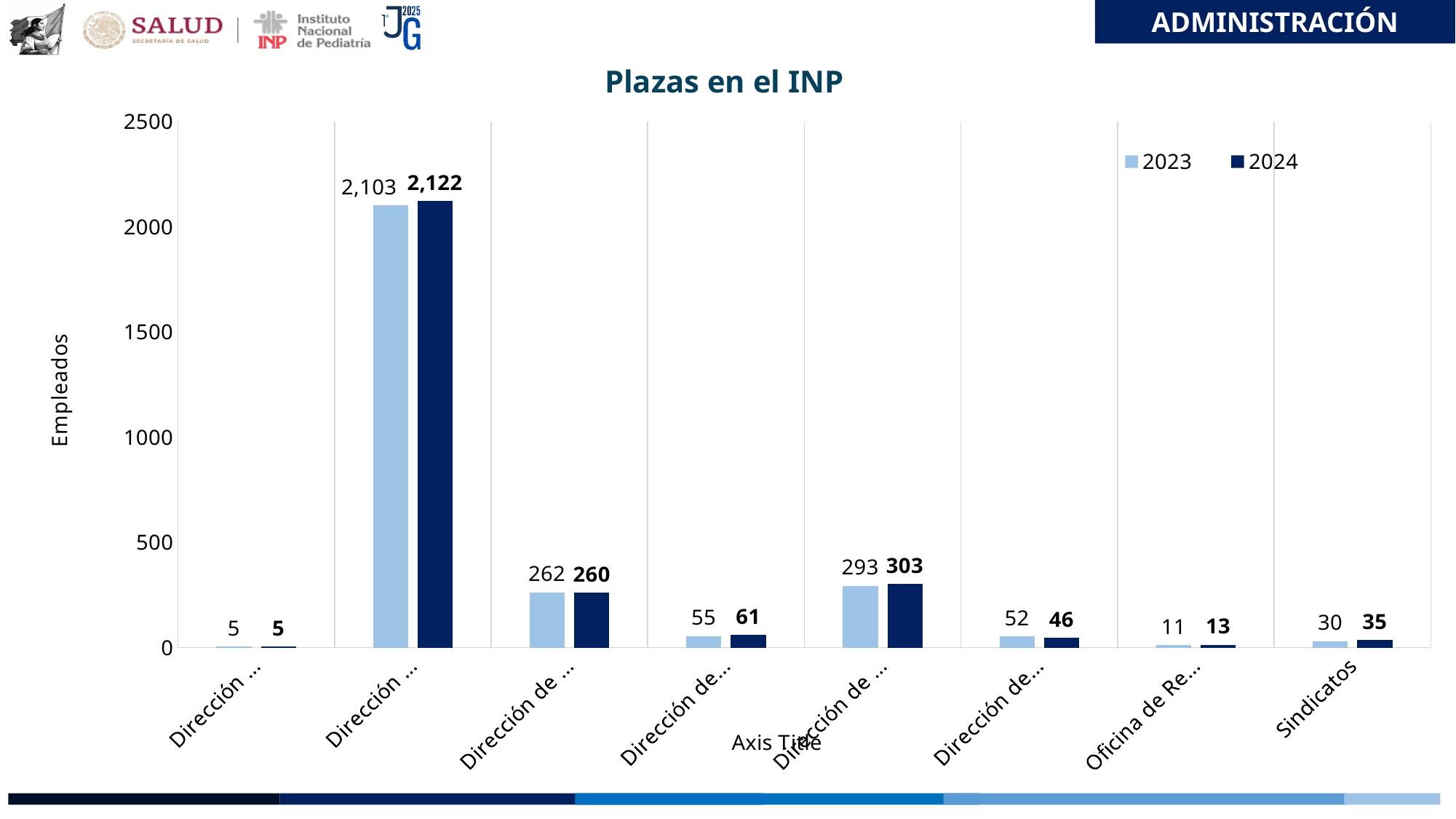
What is the 2023 value for Sindicatos? 30 What is the lowest 2023 value shown on the chart? 5 What is the label of the vertical axis? Empleados For Sindicatos, which year has the larger value, 2023 or 2024? 2024 What is the difference between the 2024 and 2023 values for the second category from the left (the tallest bars)? 19 What kind of chart is shown on the slide? bar chart What is the highest 2024 value shown on the chart? 2,122 How many series does the legend list? 2 What is the title of the chart? Plazas en el INP How many categories are shown on the x axis? 8 What is the 2024 value for Sindicatos? 35 By how much did the value for Sindicatos increase from 2023 to 2024? 5